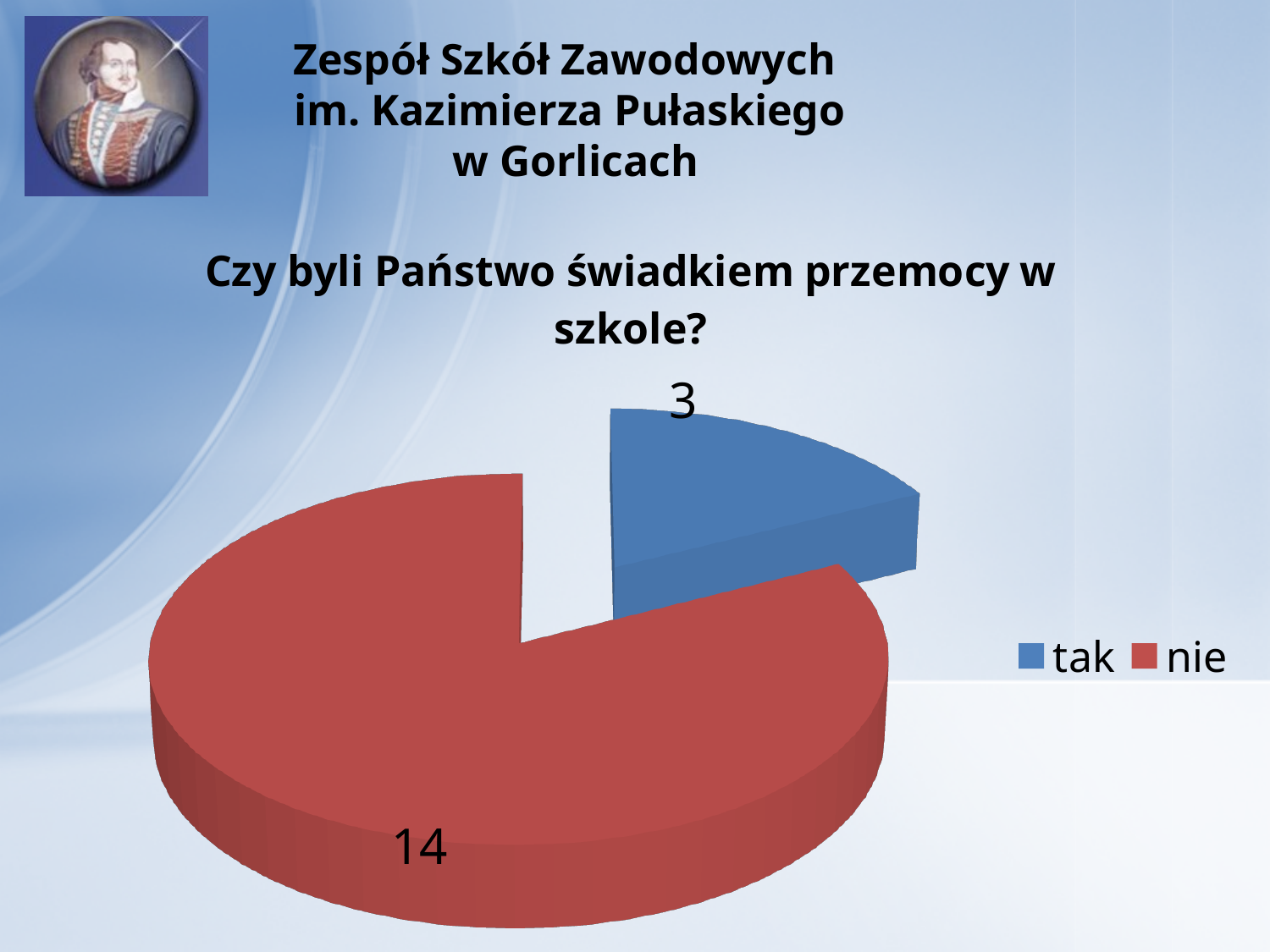
What is the title of the chart? Czy byli Państwo świadkiem przemocy w szkole? Which category has the largest slice in the pie chart? nie What is the difference between the values for "nie" and "tak"? 11 What is the value for "nie" in the pie chart? 14 Which category has the smallest slice in the pie chart? tak How many slices does the pie chart have? 2 What fraction of the total does the "tak" slice represent? 3/17 What is the total of all slices in the pie chart? 17 What is the value for "tak" in the pie chart? 3 Which is larger, the value for "tak" or the value for "nie"? nie What kind of chart is shown on the slide? pie chart How many entries does the legend list? 2